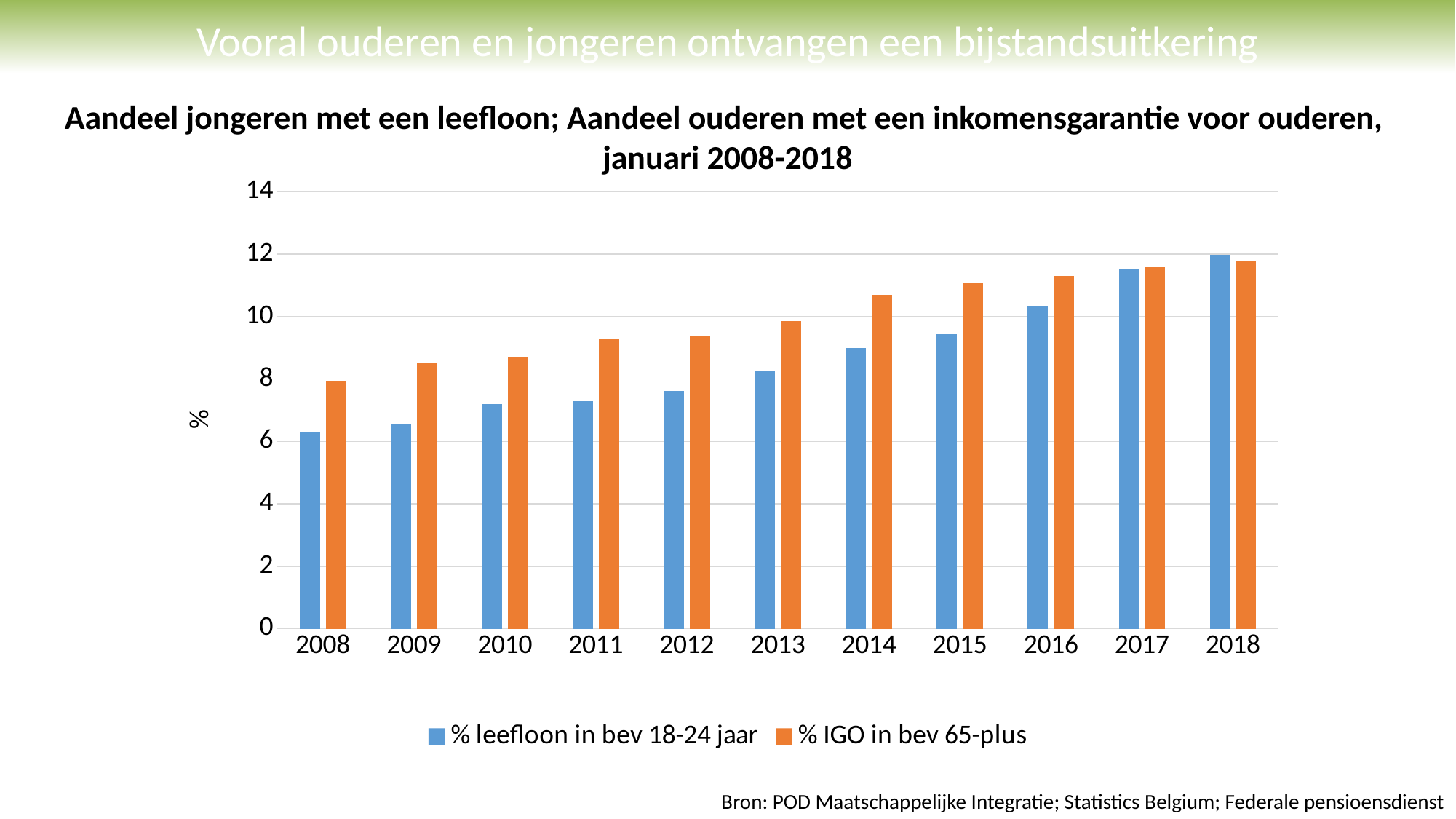
Is the value for '% IGO in bev 65-plus' in 2014 greater or less than 10? greater What kind of chart is shown on the slide? bar chart In 2008, which is larger: '% leefloon in bev 18-24 jaar' or '% IGO in bev 65-plus'? % IGO in bev 65-plus How many series does the legend list? 2 Is the value for '% leefloon in bev 18-24 jaar' in 2014 greater or less than 10? less In which year is '% leefloon in bev 18-24 jaar' highest? 2018 Which series is shown in orange in the legend? % IGO in bev 65-plus In which year is '% leefloon in bev 18-24 jaar' lowest? 2008 In 2016, which is larger: '% leefloon in bev 18-24 jaar' or '% IGO in bev 65-plus'? % IGO in bev 65-plus How many years are shown on the x axis? 11 Do the values for '% leefloon in bev 18-24 jaar' rise or fall from 2008 to 2018? rise In which year is '% IGO in bev 65-plus' lowest? 2008